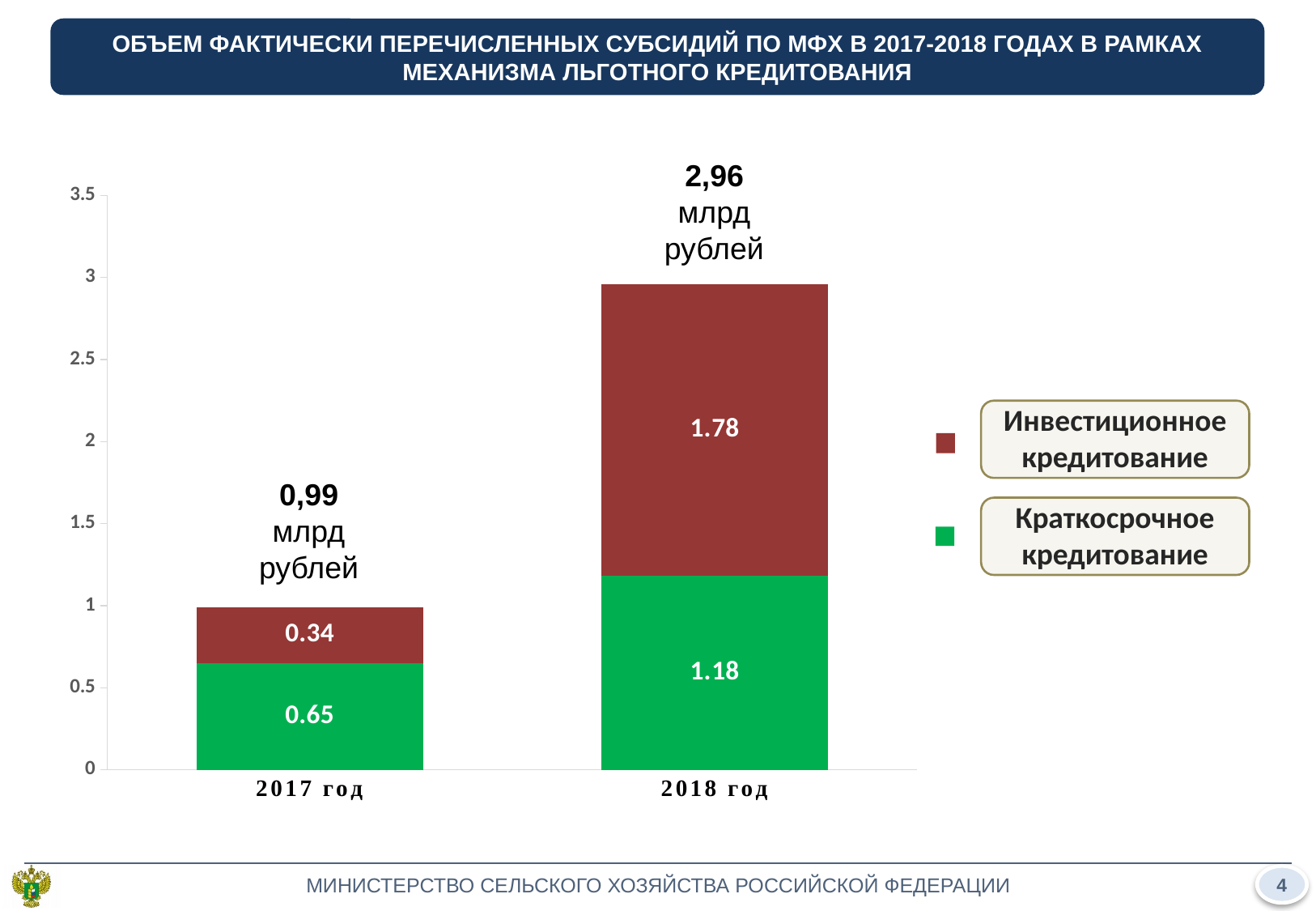
What is the value for Инвестиционное кредитование in 2017 год? 0.34 What is the value for Инвестиционное кредитование in 2018 год? 1.78 What is the value for Краткосрочное кредитование in 2018 год? 1.18 How many series does the legend list? 2 Which colour represents Краткосрочное кредитование in the chart? Green What is the value for Краткосрочное кредитование in 2017 год? 0.65 Which year has the higher total subsidy volume? 2018 год Which is larger in 2018 год: Инвестиционное кредитование or Краткосрочное кредитование? Инвестиционное кредитование What is the difference between Инвестиционное кредитование in 2018 год and in 2017 год? 1.44 What is the total labelled above the stacked bar for 2017 год? 0,99 млрд рублей What is the total labelled above the stacked bar for 2018 год? 2,96 млрд рублей What kind of chart is shown on the slide? Stacked bar chart